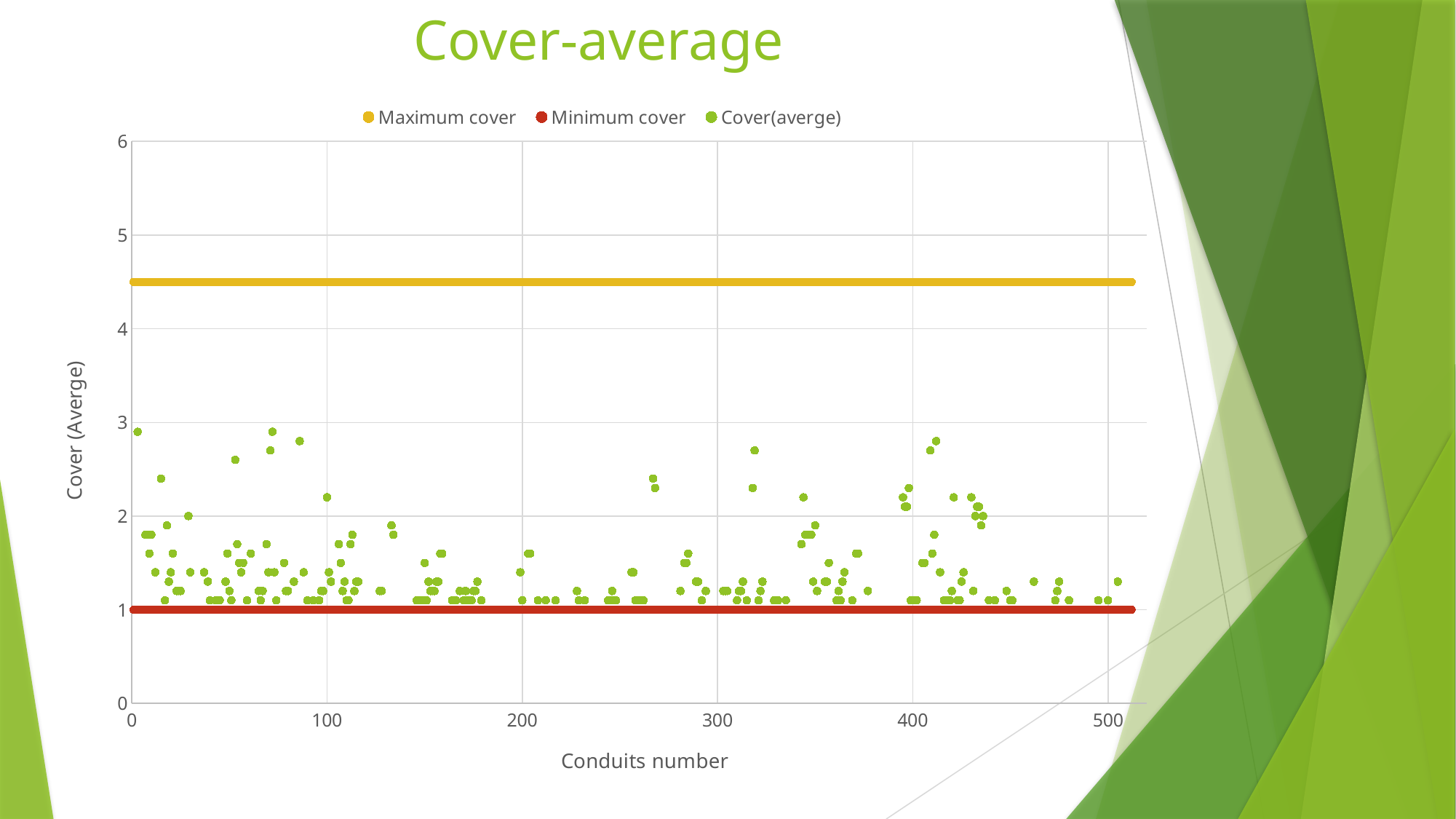
Is the value of the Maximum cover series greater or less than 4? greater How many series does the chart legend list? 3 What kind of chart is shown on the slide? scatter chart What is the label of the x axis? Conduits number Which series has the highest values: Maximum cover, Minimum cover, or Cover(averge)? Maximum cover What value does the Minimum cover series stay at across all conduits? 1 Which series has the lowest values: Maximum cover, Minimum cover, or Cover(averge)? Minimum cover Is the Maximum cover series larger or smaller than the Minimum cover series? larger What is the title of the chart? Cover-average Does the Maximum cover series rise, fall, or stay flat along the x axis? stay flat Are the Cover(averge) values greater or less than 3? less Is the value of the Maximum cover series greater or less than 5? less